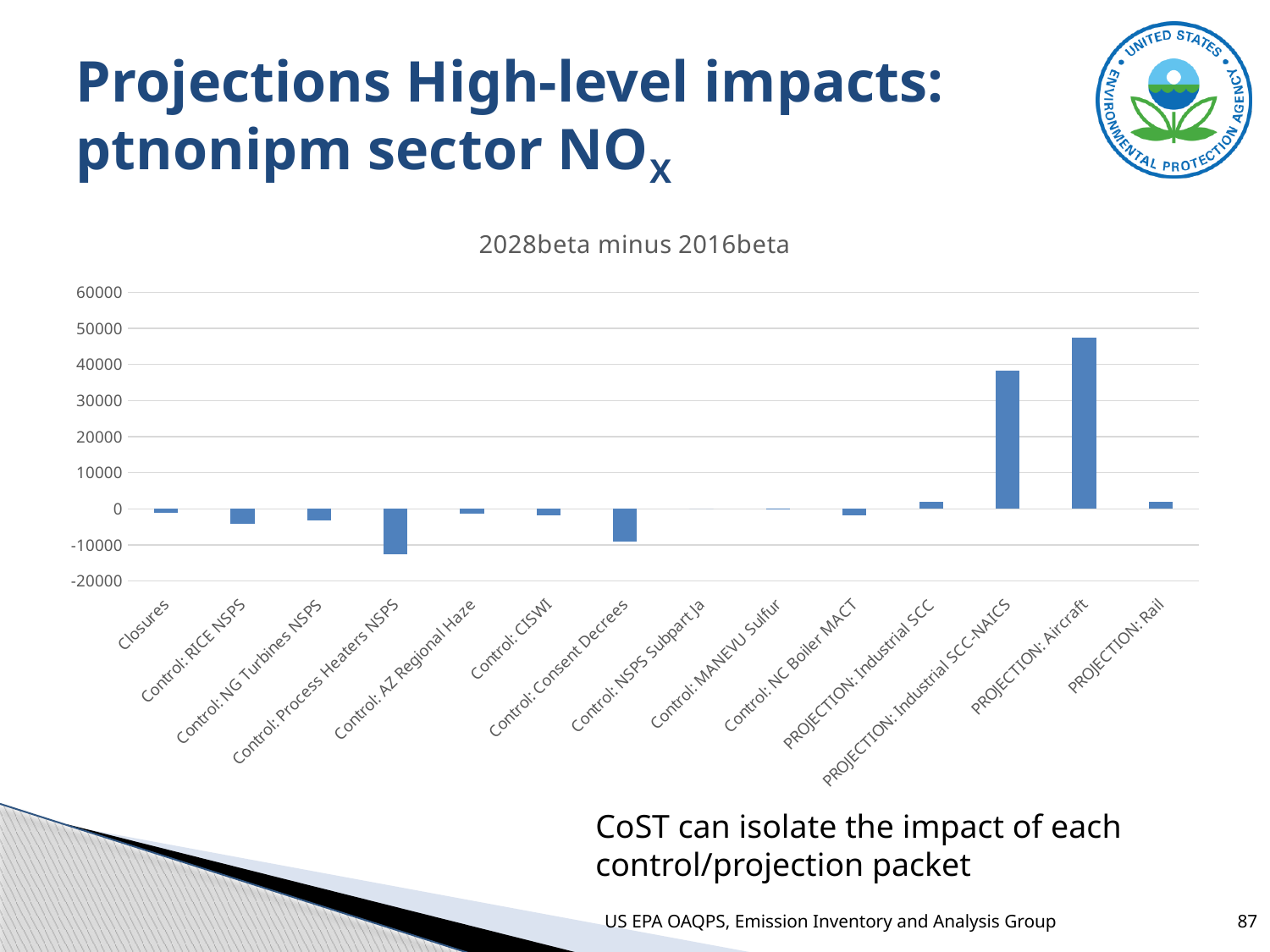
Which category has the lowest value in the chart? Control: Process Heaters NSPS Is the value for PROJECTION: Aircraft greater or less than 40000? greater Which category has the highest value in the chart? PROJECTION: Aircraft Is the value for PROJECTION: Industrial SCC-NAICS greater or less than 30000? greater What type of chart is shown on the slide? bar chart Which is larger, the value for PROJECTION: Aircraft or the value for PROJECTION: Industrial SCC-NAICS? PROJECTION: Aircraft How many categories are shown on the x axis of the chart? 14 Which is lower, the value for Control: Process Heaters NSPS or the value for Control: Consent Decrees? Control: Process Heaters NSPS What is the title of the chart? 2028beta minus 2016beta How many bars in the chart have values above zero? 4 Is the value for Control: Process Heaters NSPS greater or less than -10000? less